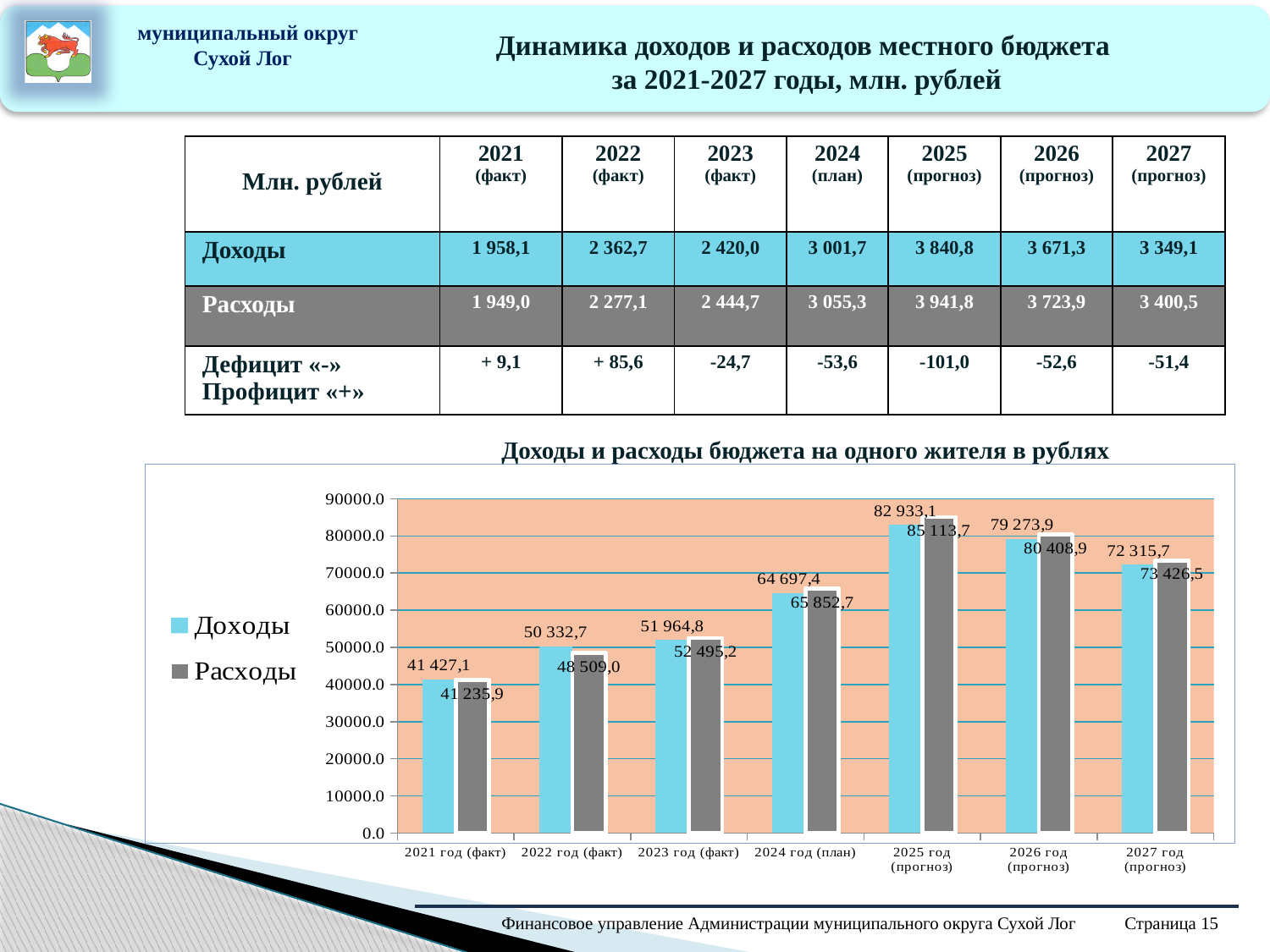
How many year categories are shown on the x axis of the chart? 7 In which year is the Доходы value highest in the chart? 2025 год (прогноз) What is the value of Расходы for 2027 год (прогноз) in the chart? 73 426,5 What is the value of Доходы for 2021 год (факт) in the chart? 41 427,1 Which is larger for 2024 год (план): Доходы or Расходы? Расходы What is the difference between Расходы and Доходы for 2025 год (прогноз)? 2 180,6 In which year is the Расходы value lowest in the chart? 2021 год (факт) What is the difference between Доходы and Расходы for 2022 год (факт)? 1 823,7 What is the value of Расходы for 2025 год (прогноз) in the chart? 85 113,7 What kind of chart is shown on the slide? Bar chart Is the Доходы value for 2026 год (прогноз) greater or less than 70000.0? greater How many series does the chart legend list? 2